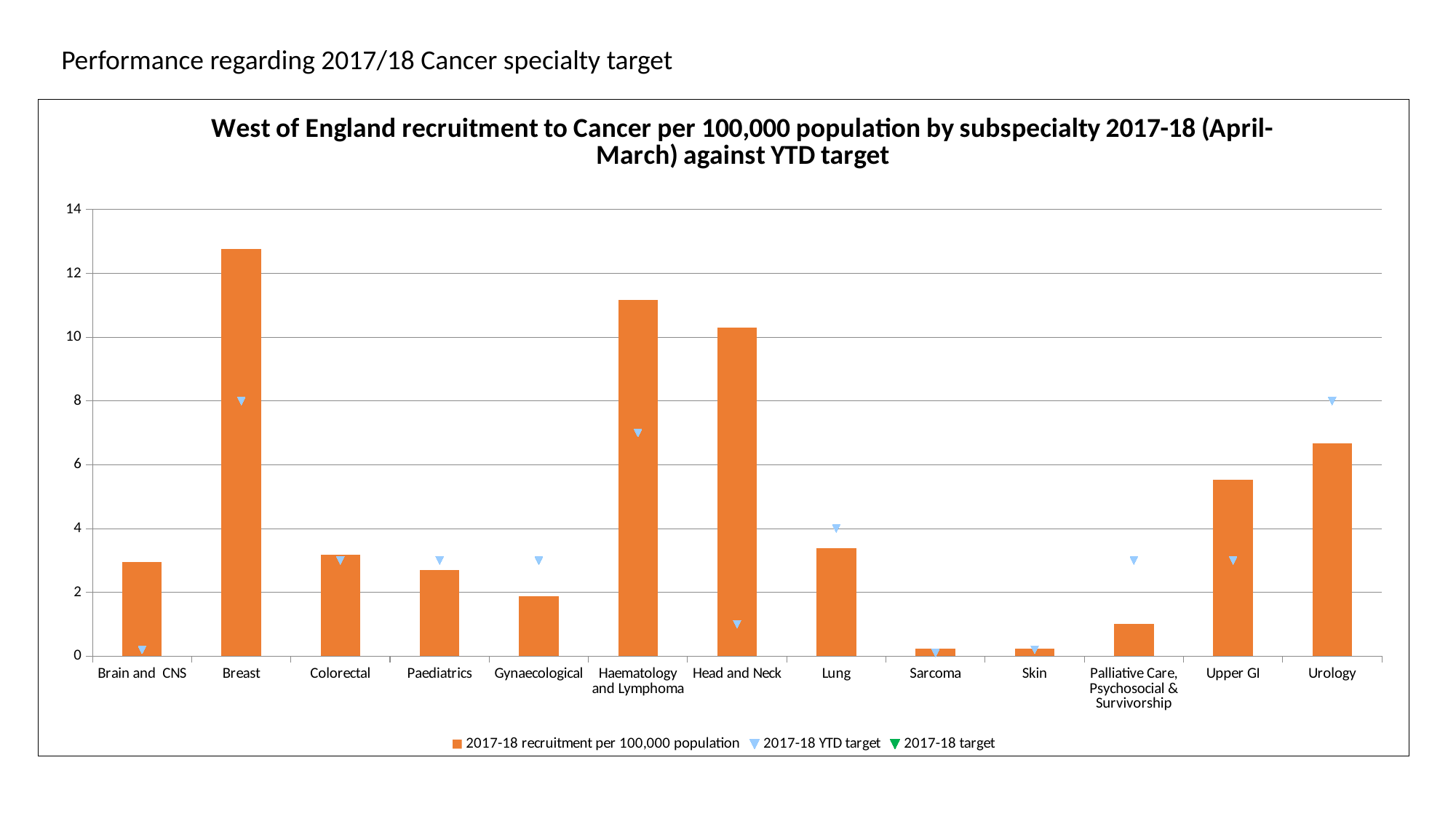
How many subspecialty categories are shown on the x axis? 13 Which has the higher 2017-18 recruitment per 100,000 population, Head and Neck or Lung? Head and Neck What is the title of the chart? West of England recruitment to Cancer per 100,000 population by subspecialty 2017-18 (April-March) against YTD target Is the 2017-18 recruitment per 100,000 population for Urology greater or less than 6? greater Which subspecialty has the highest 2017-18 recruitment per 100,000 population? Breast How many series does the legend list? 3 Is the 2017-18 recruitment per 100,000 population for Lung greater or less than 4? less Is the 2017-18 recruitment per 100,000 population for Breast greater or less than 12? greater Which has the higher 2017-18 recruitment per 100,000 population, Breast or Haematology and Lymphoma? Breast What kind of chart is shown on the slide? bar chart